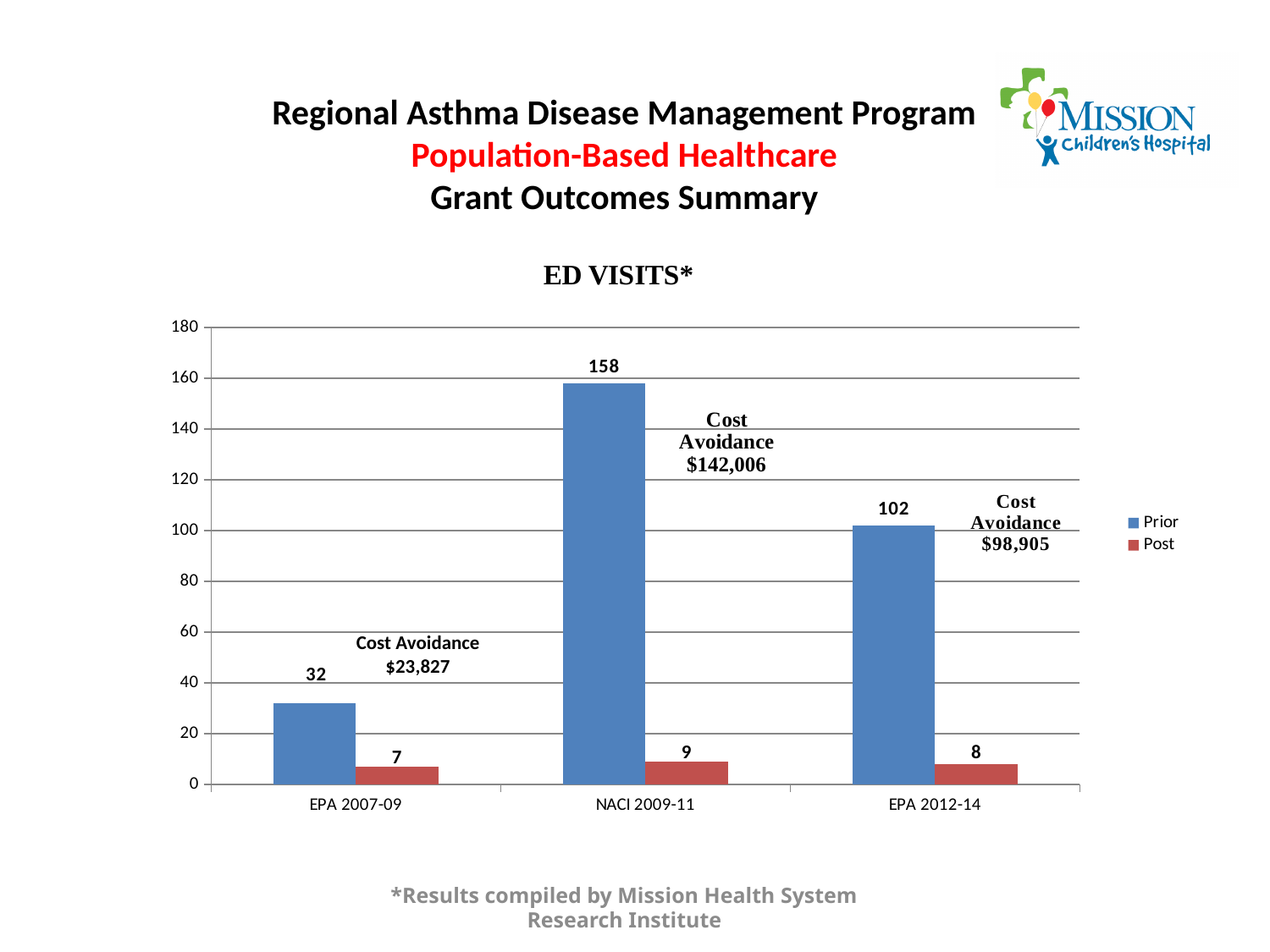
Which category has the highest Prior value? NACI 2009-11 What is the difference between the Prior values for EPA 2012-14 and EPA 2007-09? 70 Which category has the lowest Post value? EPA 2007-09 Which is larger, the Prior value for EPA 2007-09 or the Prior value for EPA 2012-14? EPA 2012-14 How many categories are shown on the x axis? 3 What is the Prior value for EPA 2012-14? 102 What kind of chart is this? bar chart What is the cost avoidance shown for NACI 2009-11? $142,006 What is the Prior value for NACI 2009-11? 158 How many series does the legend list? 2 What is the difference between the Prior and Post values for NACI 2009-11? 149 What is the Post value for EPA 2007-09? 7